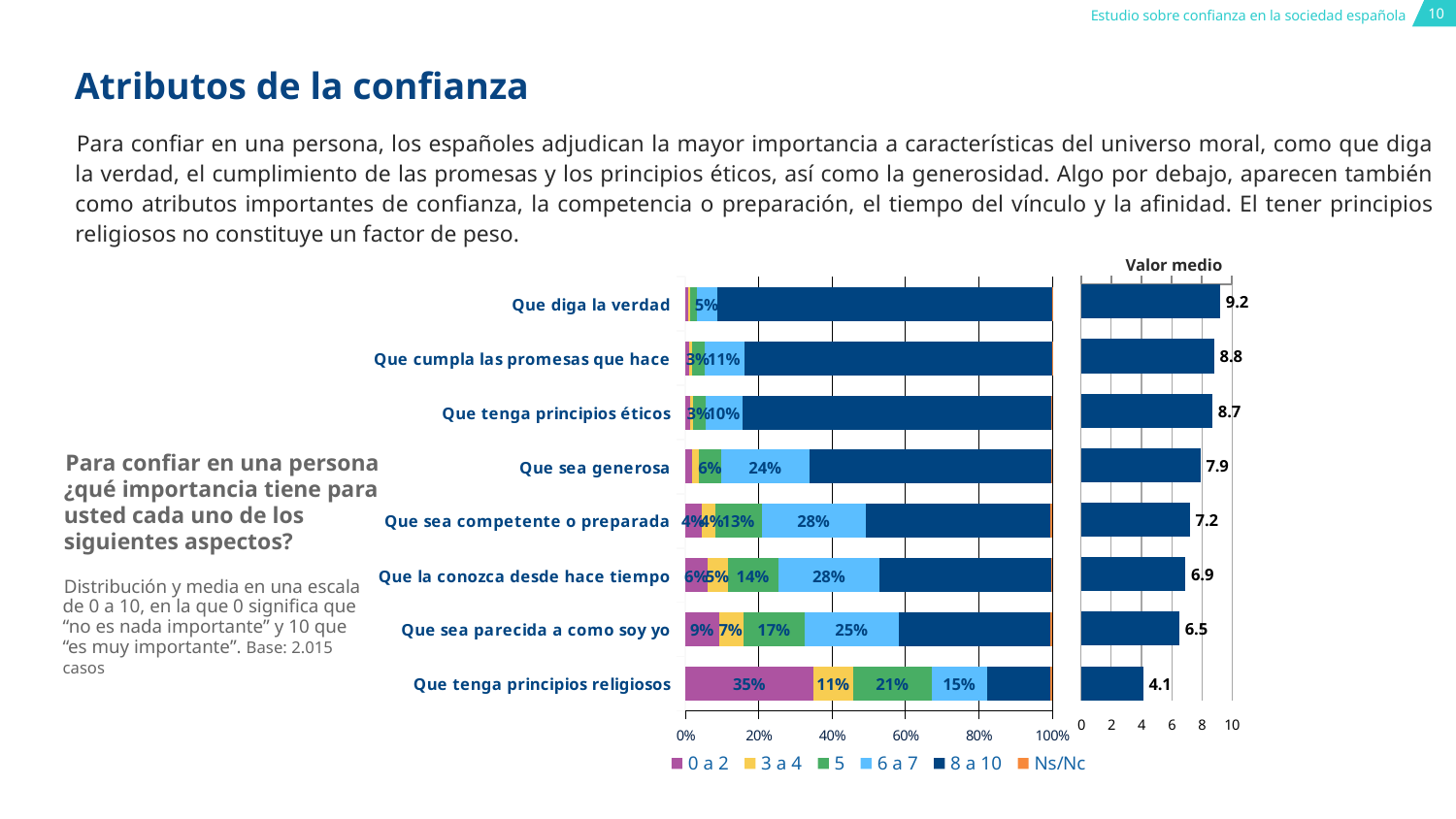
How many series does the legend of the stacked distribution chart list? 6 In the 'Valor medio' chart, what is the difference between the mean values for 'Que diga la verdad' and 'Que tenga principios religiosos'? 5.1 In the 'Valor medio' chart, what is the mean value for 'Que diga la verdad'? 9.2 In the stacked distribution chart, what percentage gave '6 a 7' for 'Que sea generosa'? 24% In the stacked distribution chart, is the '8 a 10' share for 'Que diga la verdad' greater or less than 80%? greater What kind of chart is the distribution chart on the left? Stacked bar chart How many aspects (categories) are shown in the stacked distribution chart? 8 In the 'Valor medio' chart, what is the mean value for 'Que sea parecida a como soy yo'? 6.5 In the 'Valor medio' chart, which aspect has the highest mean value? Que diga la verdad In the 'Valor medio' chart, which has a higher mean value: 'Que sea generosa' or 'Que sea competente o preparada'? Que sea generosa In the stacked distribution chart, what percentage of respondents gave '0 a 2' for 'Que tenga principios religiosos'? 35% In the 'Valor medio' chart, which aspect has the lowest mean value? Que tenga principios religiosos